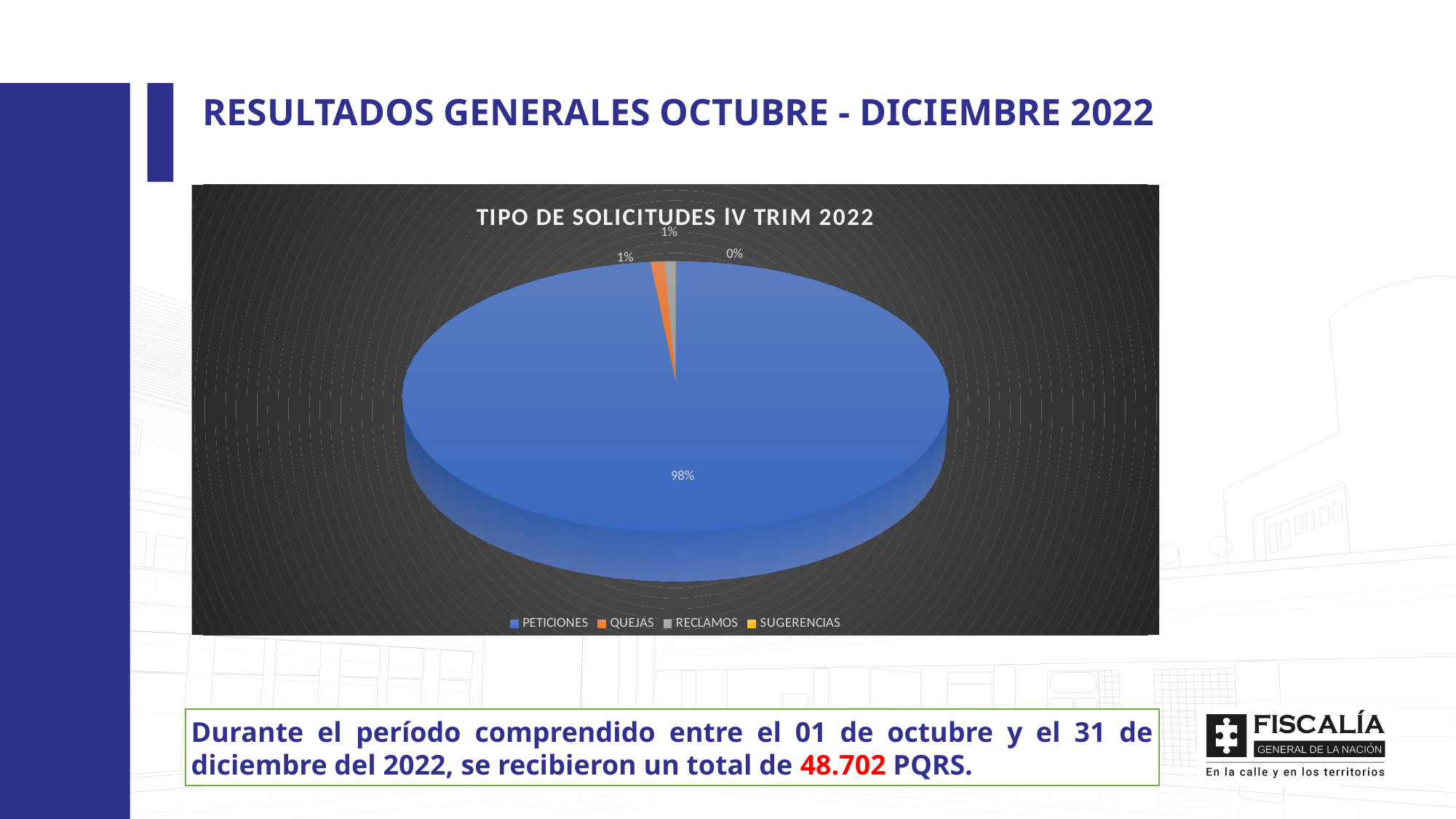
What share of the pie does QUEJAS represent? 1% What share of the pie does PETICIONES represent? 98% Which is larger, the share for PETICIONES or the share for QUEJAS? PETICIONES What share of the pie does RECLAMOS represent? 1% What colour represents PETICIONES in the chart? Blue Which category has the largest slice of the pie? PETICIONES Which category has the smallest slice of the pie? SUGERENCIAS What is the title of the chart? TIPO DE SOLICITUDES IV TRIM 2022 What kind of chart is shown on the slide? Pie chart What is the difference in percentage points between the PETICIONES share and the QUEJAS share? 97 percentage points How many categories does the legend list? 4